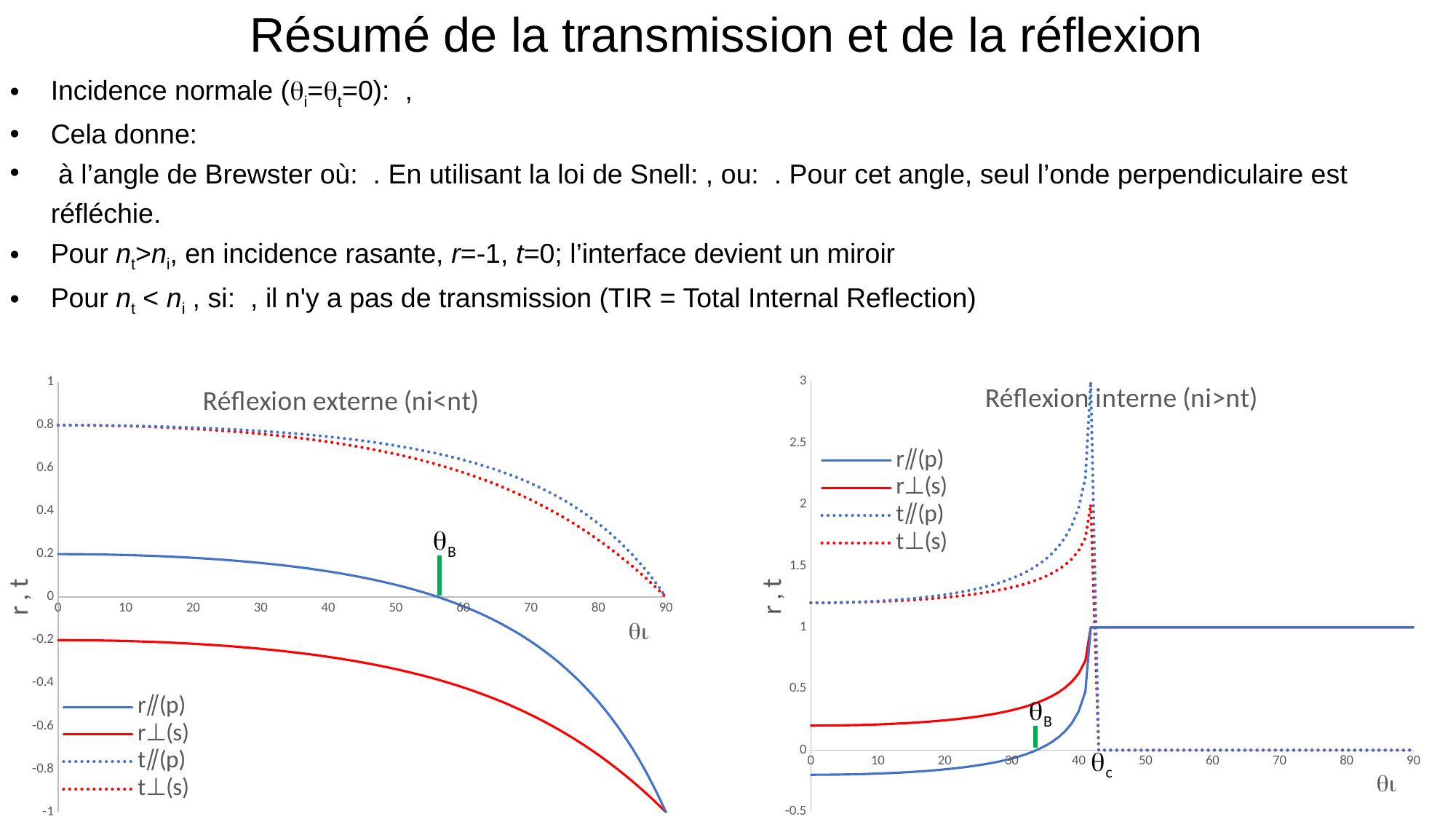
In the left chart "Réflexion externe (ni<nt)", what value do the r∥(p) and r⊥(s) curves reach at θi = 90? -1 In the left chart, which series is drawn as a solid red line? r⊥(s) How many series does the legend of the right chart "Réflexion interne (ni>nt)" list? 4 In the left chart "Réflexion externe (ni<nt)", what value do the t∥(p) and t⊥(s) curves reach at θi = 90? 0 In the left chart "Réflexion externe (ni<nt)", does the t∥(p) curve rise or fall as θi increases from 0 to 90? fall What kind of chart is the left chart titled "Réflexion externe (ni<nt)"? line chart In the left chart "Réflexion externe (ni<nt)", is the value of r⊥(s) at θi = 30 greater or less than 0? less In the right chart "Réflexion interne (ni>nt)", what is the value of r∥(p) at θi = 60? 1 In the right chart "Réflexion interne (ni>nt)", is the value of t∥(p) at θi = 30 greater or less than 1? greater In the left chart "Réflexion externe (ni<nt)", is the value of t∥(p) at θi = 40 greater or less than 0.6? greater In the right chart "Réflexion interne (ni>nt)", what is the value of t⊥(s) at θi = 70? 0 In the right chart "Réflexion interne (ni>nt)", which series reaches the higher peak near the critical angle, t∥(p) or t⊥(s)? t∥(p)